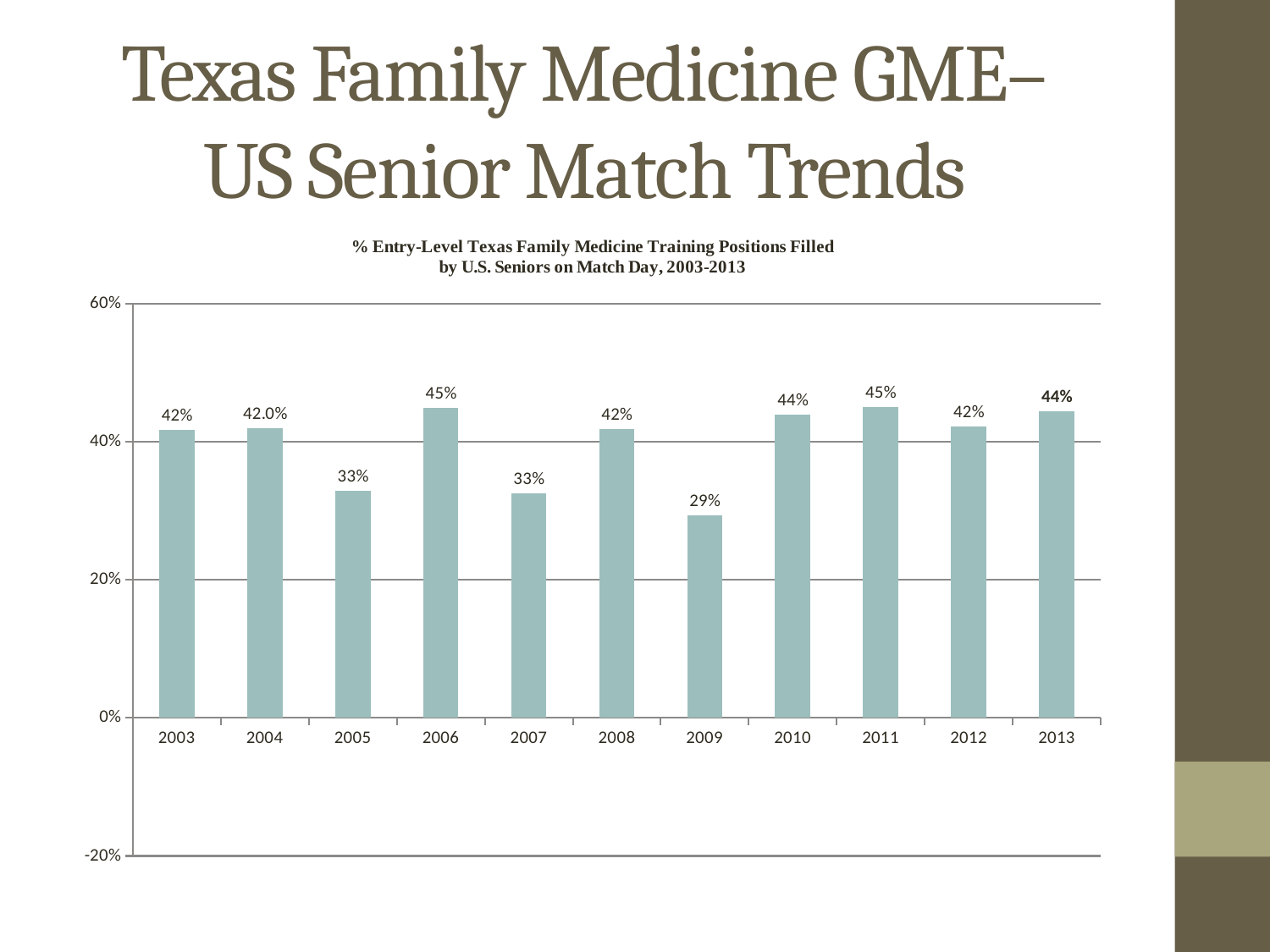
What is the value for 2013? 44% What is the value for 2006? 45% What is the value for 2009? 29% Is the value for 2009 greater or less than 40%? less Do the values rise or fall from 2009 to 2011? rise Which is larger, the value for 2010 or the value for 2009? 2010 What is the title of the chart? % Entry-Level Texas Family Medicine Training Positions Filled by U.S. Seniors on Match Day, 2003-2013 What is the difference between the values for 2006 and 2009? 16 percentage points What is the value for 2004? 42.0% What kind of chart is shown on the slide? bar chart How many years are shown on the x axis? 11 Which year has the lowest value? 2009